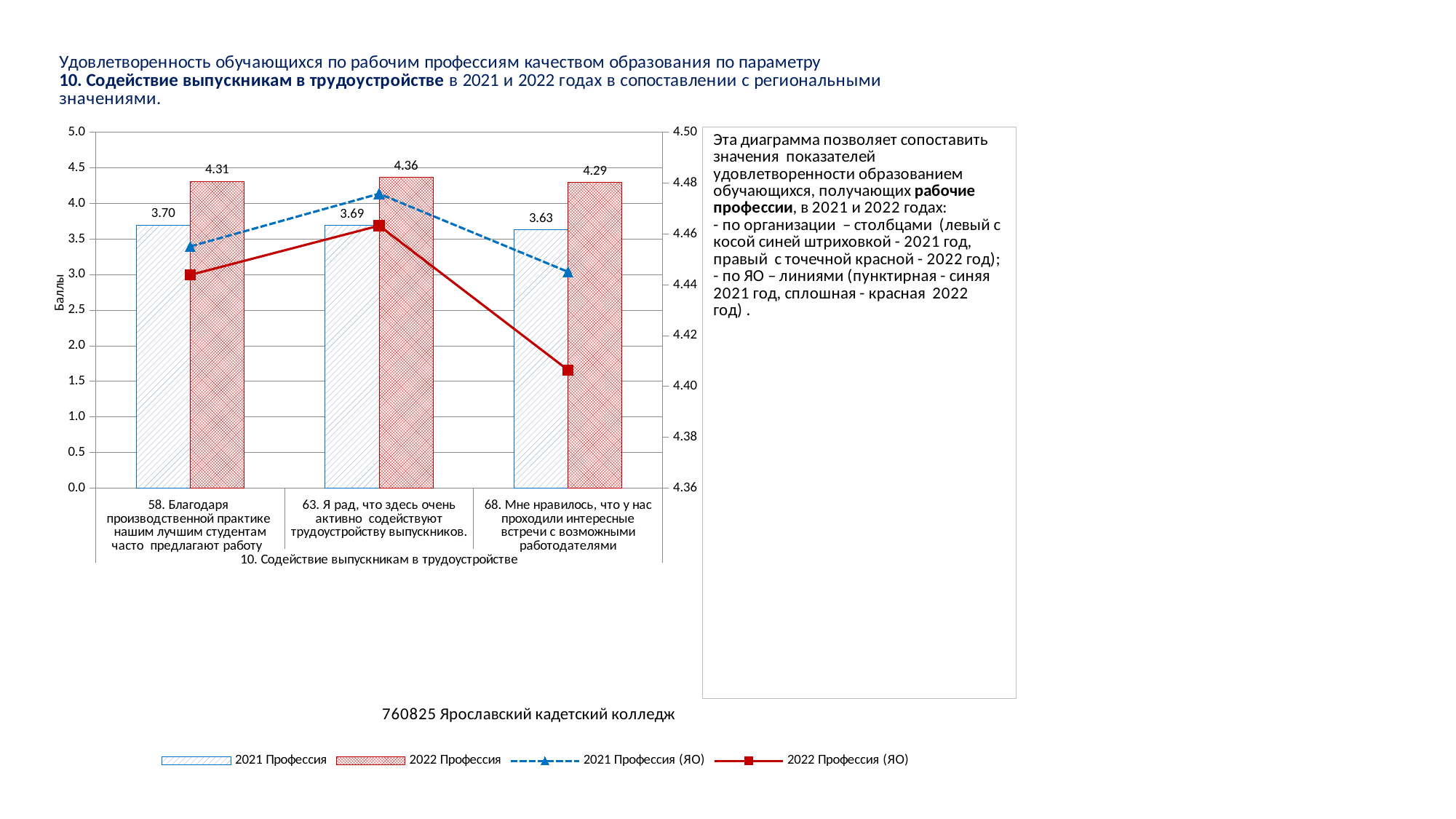
Which category has the lowest 2021 Профессия bar? 68. Мне нравилось, что у нас проходили интересные встречи с возможными работодателями What kind of chart is used for the 2021 Профессия and 2022 Профессия series? Bar chart Does the 2022 Профессия (ЯО) line rise or fall from category 63 to category 68? Fall What is the value of the 2021 Профессия bar for category 58 (Благодаря производственной практике нашим лучшим студентам часто предлагают работу)? 3.70 Which is larger: the 2021 Профессия value for category 63 or for category 68? Category 63 (3.69) On the right-hand axis, is the 2022 Профессия (ЯО) value for category 68 greater or less than 4.42? less Which category has the highest 2022 Профессия bar? 63. Я рад, что здесь очень активно содействуют трудоустройству выпускников. What is the value of the 2022 Профессия bar for category 63 (Я рад, что здесь очень активно содействуют трудоустройству выпускников)? 4.36 For category 58, how much higher is the 2022 Профессия value than the 2021 Профессия value? 0.61 How many categories (questions) are shown on the x axis? 3 How many series does the legend list? 4 What is the value of the 2022 Профессия bar for category 68 (Мне нравилось, что у нас проходили интересные встречи с возможными работодателями)? 4.29